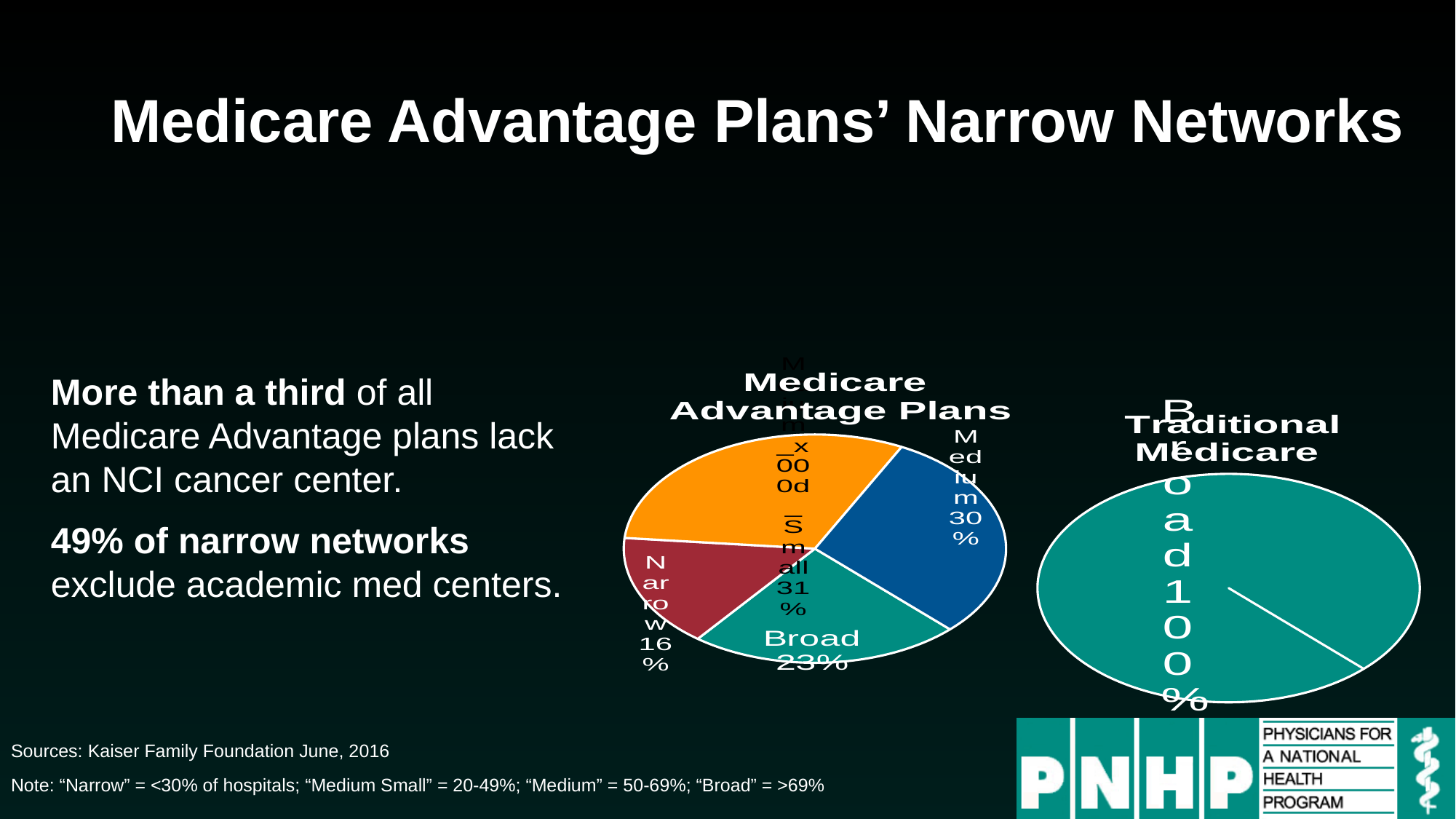
In the "Medicare Advantage Plans" chart, which is larger: the Broad share or the Narrow share? Broad In the "Traditional Medicare" chart, what share is labelled Broad? 100% In the "Medicare Advantage Plans" chart, what is the difference between the Broad share and the Narrow share? 7% What kind of chart is the "Medicare Advantage Plans" chart? Pie chart In the "Traditional Medicare" chart, how many network categories are shown? 1 In the "Medicare Advantage Plans" chart, which network category has the smallest share? Narrow In the "Medicare Advantage Plans" chart, what share of plans have Broad networks? 23% In the "Medicare Advantage Plans" chart, how many slices does the pie have? 4 In the "Medicare Advantage Plans" chart, what share of plans have Medium networks? 30% In the "Medicare Advantage Plans" chart, what share of plans have Narrow networks? 16% In the "Medicare Advantage Plans" chart, what colour is the Narrow slice? Red In the "Medicare Advantage Plans" chart, what is the difference between the Medium share and the Broad share? 7%